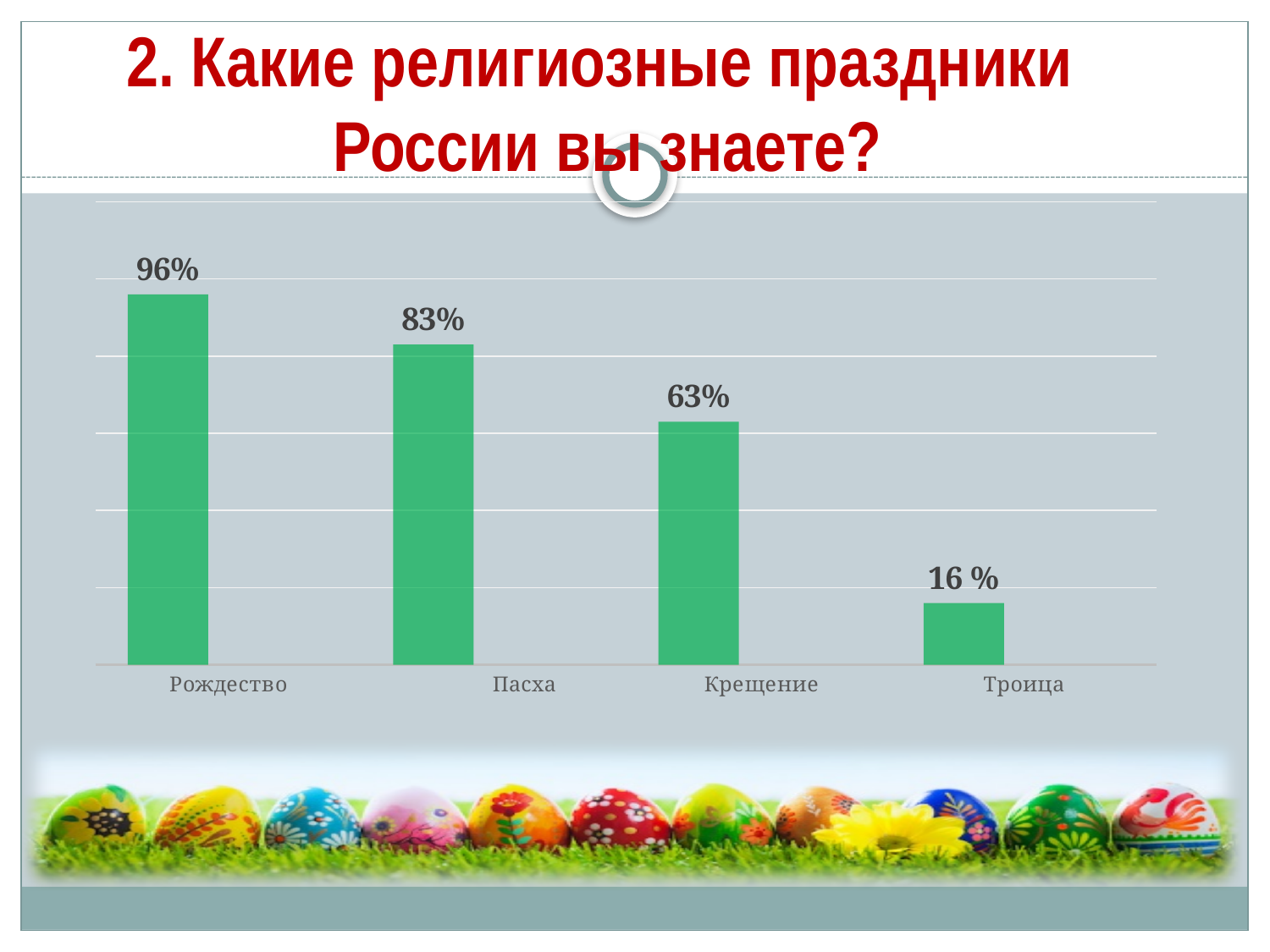
Do the values rise or fall from left to right along the x axis? Fall Which category has the highest value? Рождество Which is larger, the value for Пасха or the value for Крещение? Пасха What is the value for Рождество? 96% How many categories are shown on the chart? 4 What is the difference between the values for Рождество and Пасха? 13% What is the value for Крещение? 63% What is the difference between the values for Крещение and Троица? 47% Which category has the lowest value? Троица What is the value for Троица? 16 % What kind of chart is shown on the slide? Bar chart What is the value for Пасха? 83%